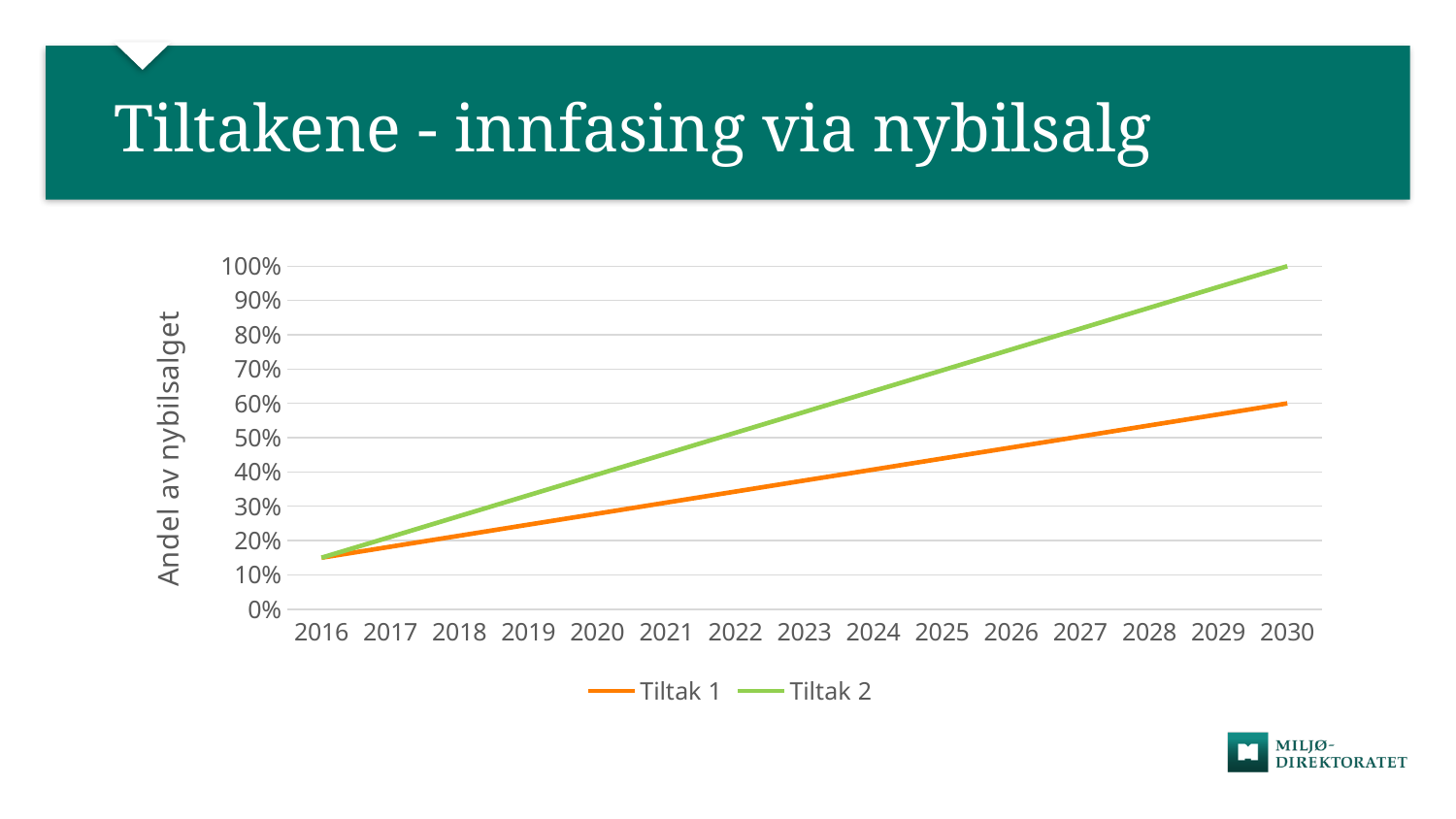
What is the value for Tiltak 1 in 2030? 60% What colour is the line for Tiltak 2? Green What type of chart is shown on the slide? Line chart How many series does the legend list? 2 Do the values for Tiltak 1 rise or fall from 2016 to 2030? Rise What is the title of the y axis? Andel av nybilsalget Is the value for Tiltak 1 in 2016 greater or less than 20%? less How many years are shown along the x axis? 15 Which series has the higher value in 2030, Tiltak 1 or Tiltak 2? Tiltak 2 What is the value for Tiltak 2 in 2030? 100% Is the value for Tiltak 2 in 2026 greater or less than 70%? greater What is the difference between Tiltak 2 and Tiltak 1 in 2030? 40 percentage points